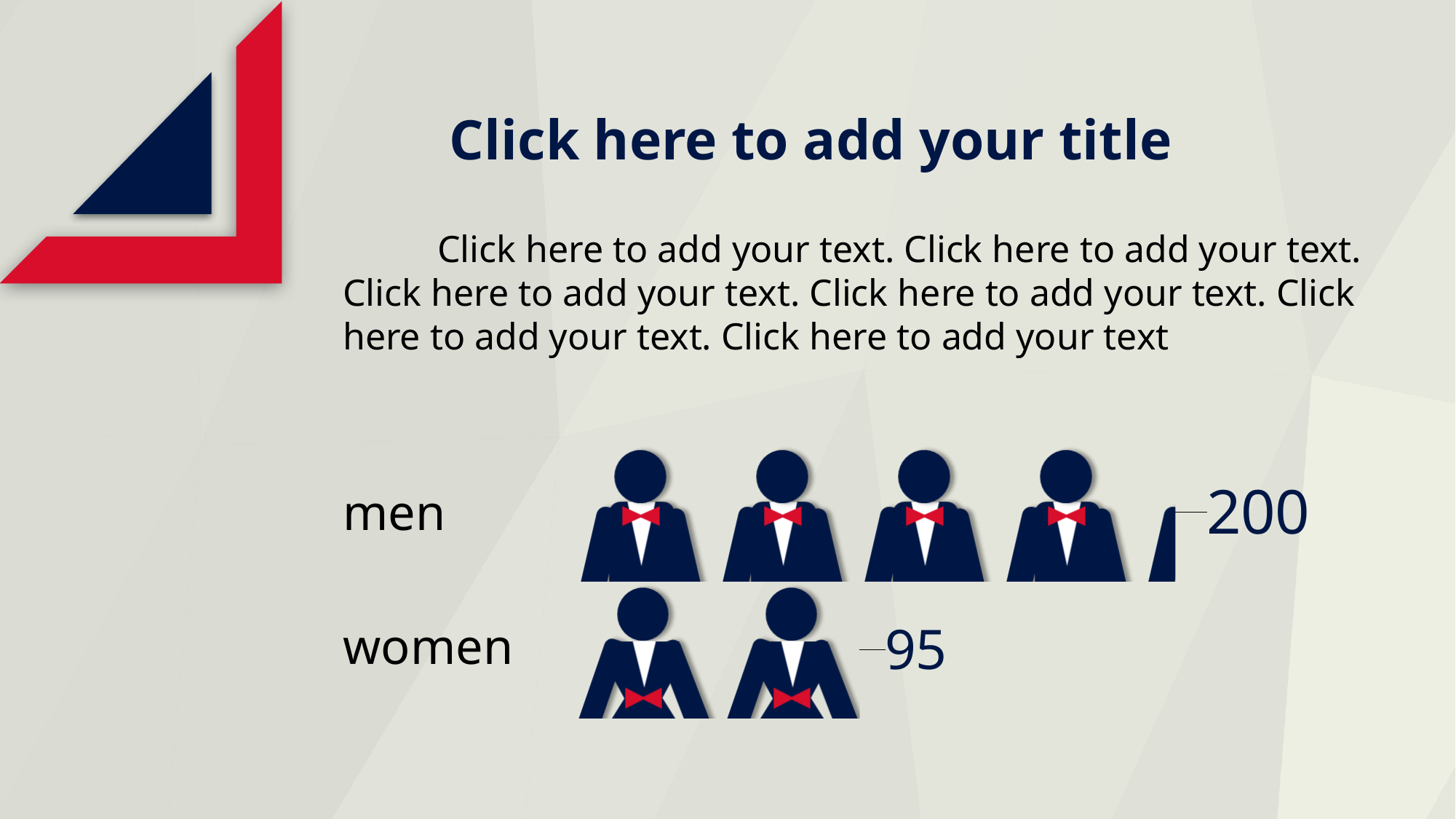
What is the difference between the value for men and the value for women? 105 Which category has the higher value, men or women? men How many full person icons are shown in the women row? 2 What kind of chart is this? pictogram (icon chart) How many categories are shown in the chart? 2 What is the value shown for men? 200 What are the two category labels in the chart? men, women Which category has the lower value? women What is the value shown for women? 95 Is the value for women larger or smaller than the value for men? smaller